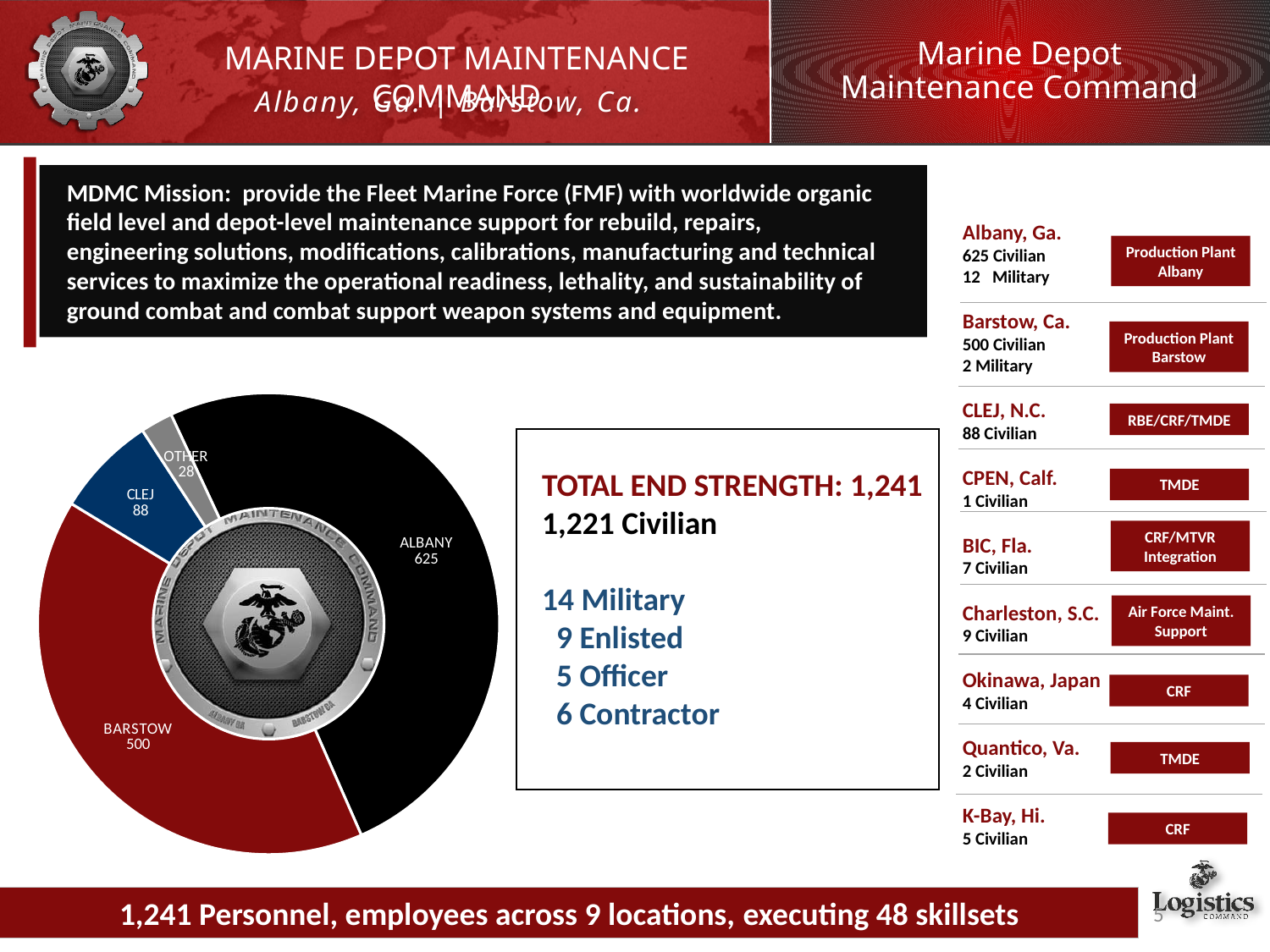
Which is larger in the pie chart, CLEJ or OTHER? CLEJ What colour is the BARSTOW slice in the pie chart? Red How many slices does the pie chart have? 4 What value is shown for ALBANY in the pie chart? 625 What value is shown for OTHER in the pie chart? 28 Which slice of the pie chart is the smallest? OTHER What value is shown for BARSTOW in the pie chart? 500 What is the total of all the slices in the pie chart? 1,241 Which slice of the pie chart is the largest? ALBANY What kind of chart is shown on the slide? Doughnut chart What is the difference between the ALBANY and BARSTOW values in the pie chart? 125 What value is shown for CLEJ in the pie chart? 88